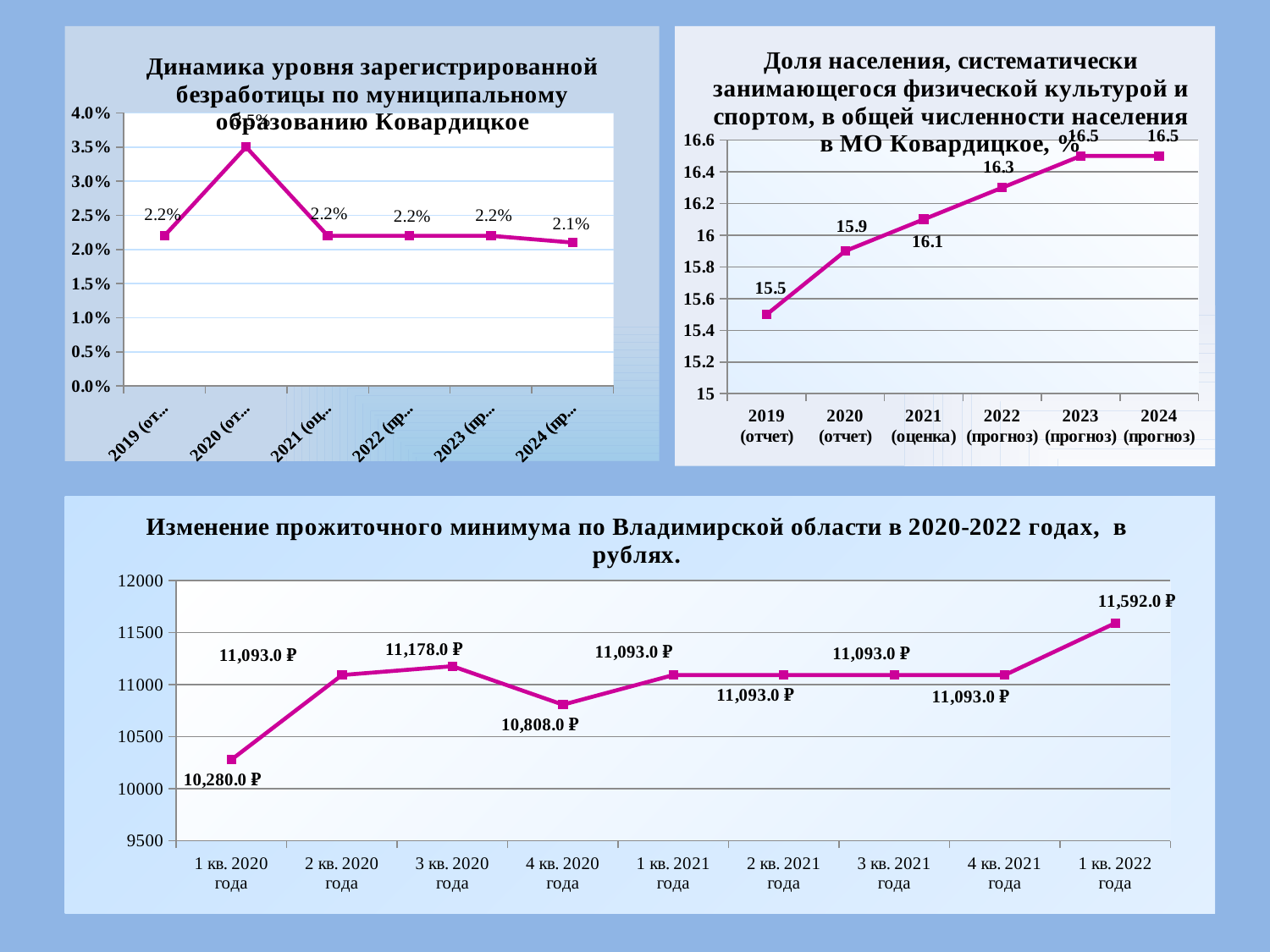
In the top-right chart (Доля населения, систематически занимающегося физической культурой и спортом), do the values generally rise or fall from 2019 to 2024? rise In the bottom chart (Изменение прожиточного минимума по Владимирской области), what is the difference between the values for 1 кв. 2022 года and 4 кв. 2021 года? 499.0 ₽ In the bottom chart (Изменение прожиточного минимума по Владимирской области), how many quarters are plotted? 9 What kind of chart is the top-left chart (Динамика уровня зарегистрированной безработицы)? line chart In the top-right chart (Доля населения, систематически занимающегося физической культурой и спортом), which is larger, the value for 2020 (отчет) or 2022 (прогноз)? 2022 (прогноз) In the top-left chart (Динамика уровня зарегистрированной безработицы), which year has the highest value? 2020 In the top-right chart (Доля населения, систематически занимающегося физической культурой и спортом), what is the value for 2021 (оценка)? 16.1 In the top-left chart (Динамика уровня зарегистрированной безработицы), what is the value for 2024? 2.1% In the bottom chart (Изменение прожиточного минимума по Владимирской области), which quarter has the lowest value? 1 кв. 2020 года In the bottom chart (Изменение прожиточного минимума по Владимирской области), which quarter has the highest value? 1 кв. 2022 года In the top-right chart (Доля населения, систематически занимающегося физической культурой и спортом), what is the difference between the values for 2023 (прогноз) and 2019 (отчет)? 1.0 In the bottom chart (Изменение прожиточного минимума по Владимирской области), what is the value for 1 кв. 2020 года? 10,280.0 ₽